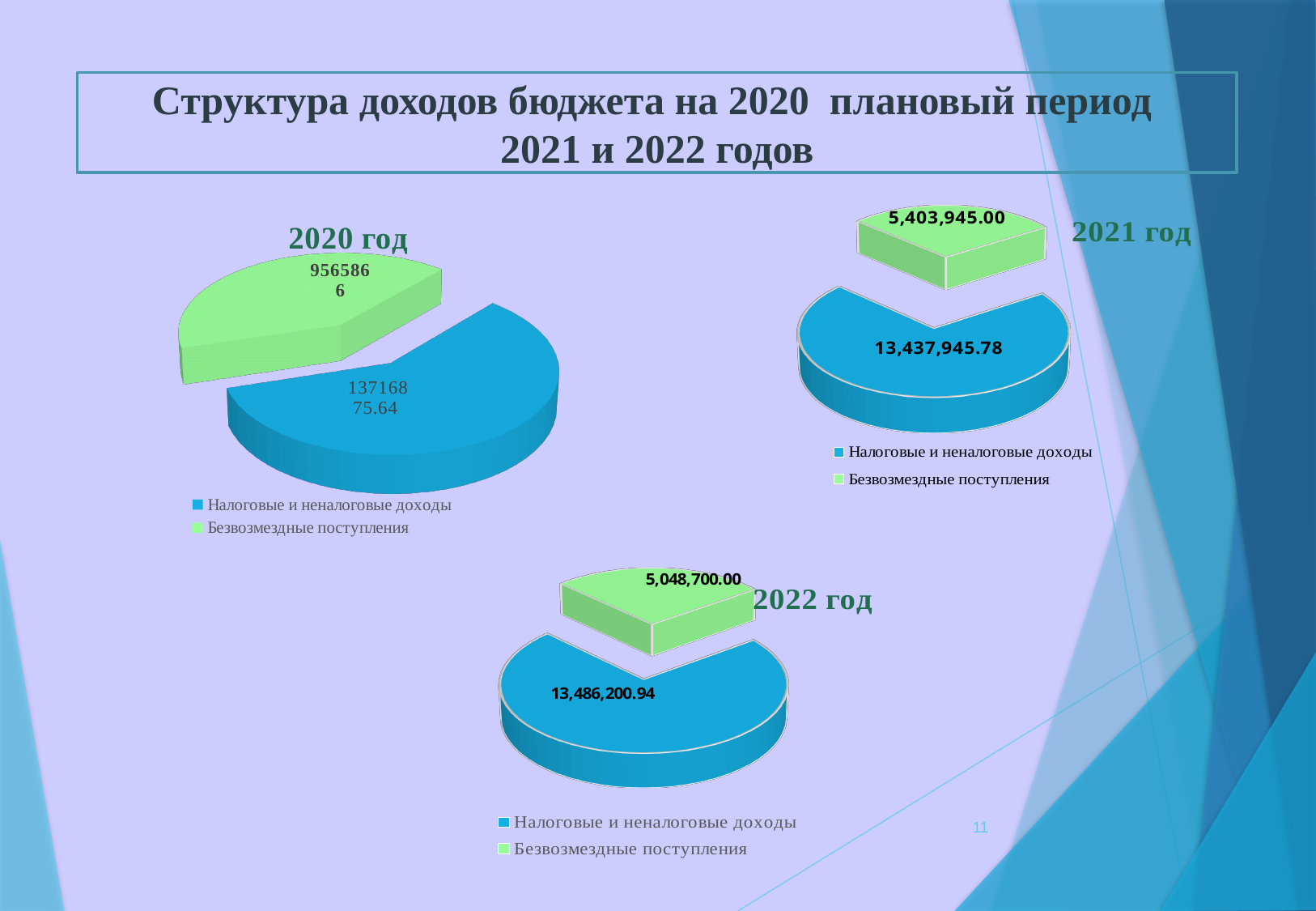
In the 2021 год chart, what is the value for Безвозмездные поступления? 5,403,945.00 In the 2021 год chart, what is the value for Налоговые и неналоговые доходы? 13,437,945.78 In the 2020 год chart, which category has the largest slice? Налоговые и неналоговые доходы Which is larger: Налоговые и неналоговые доходы in the 2021 год chart or in the 2022 год chart? 2022 год In the 2021 год chart, what is the difference between Налоговые и неналоговые доходы and Безвозмездные поступления? 8,034,000.78 In the 2022 год chart, how many series does the legend list? 2 How many pie charts are shown on the slide? 3 In the 2022 год chart, which category has the smallest slice? Безвозмездные поступления In the 2022 год chart, what is the value for Безвозмездные поступления? 5,048,700.00 In the 2022 год chart, what is the value for Налоговые и неналоговые доходы? 13,486,200.94 What kind of chart is used for the 2021 год chart? pie chart What colour represents Безвозмездные поступления in the charts? green